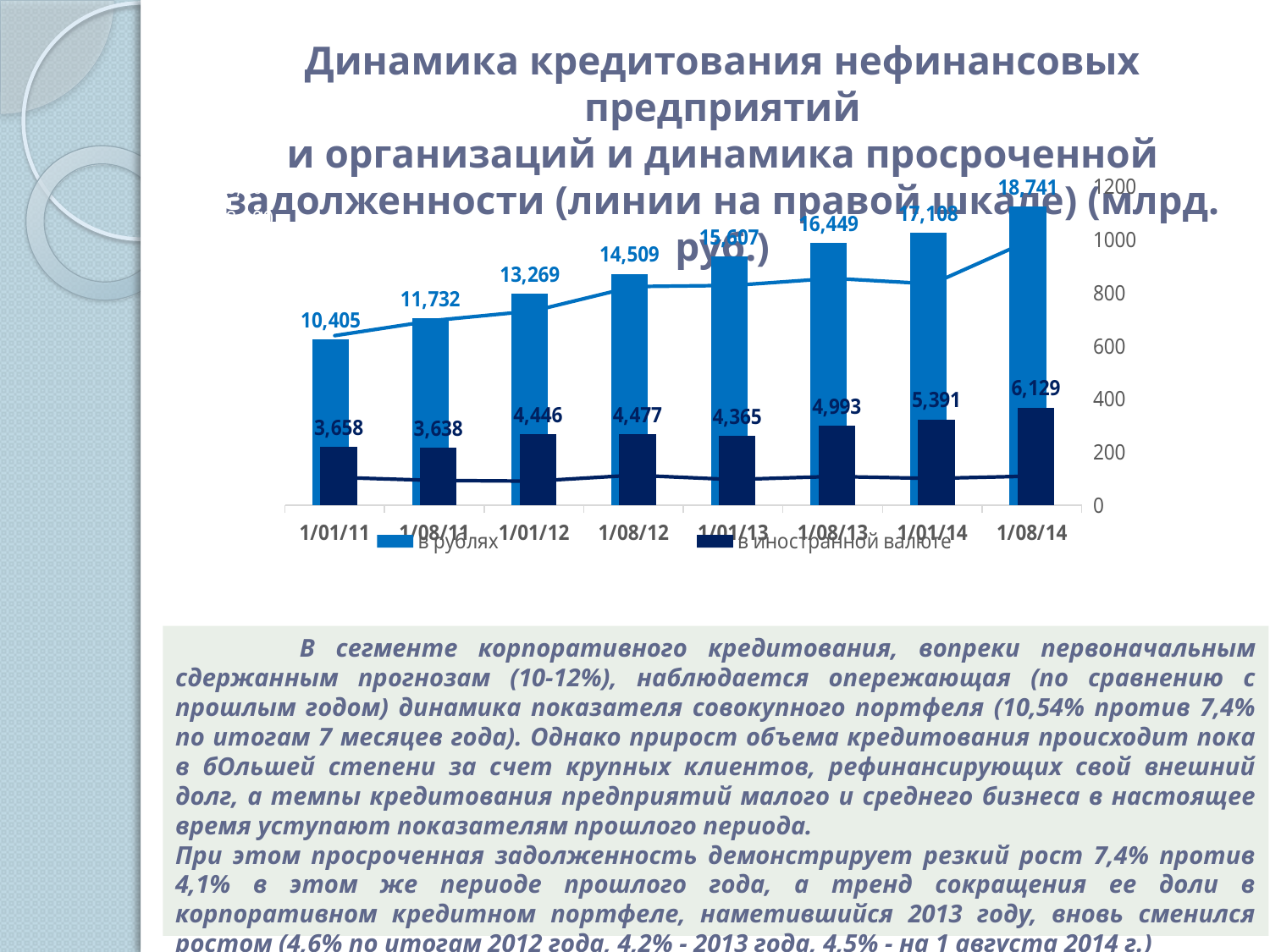
Do the 'в рублях' values rise or fall from 1/01/11 to 1/08/14? rise What is the value of the 'в иностранной валюте' bar for 1/08/14? 6,129 What are the two entries shown in the chart legend? в рублях; в иностранной валюте What is the difference between the 'в рублях' and 'в иностранной валюте' values for 1/01/14? 11,717 What is the value of the 'в рублях' bar for 1/01/11? 10,405 Which date has the highest 'в рублях' value? 1/08/14 What is the value of the 'в рублях' bar for 1/01/13? 15,607 What kind of chart is shown on the slide? bar chart with lines Which is larger: the 'в иностранной валюте' value for 1/08/12 or for 1/01/13? 1/08/12 What is the difference between the 'в рублях' values for 1/08/14 and 1/01/11? 8,336 How many dates are shown on the x axis of the chart? 8 Which date has the lowest 'в иностранной валюте' value? 1/08/11